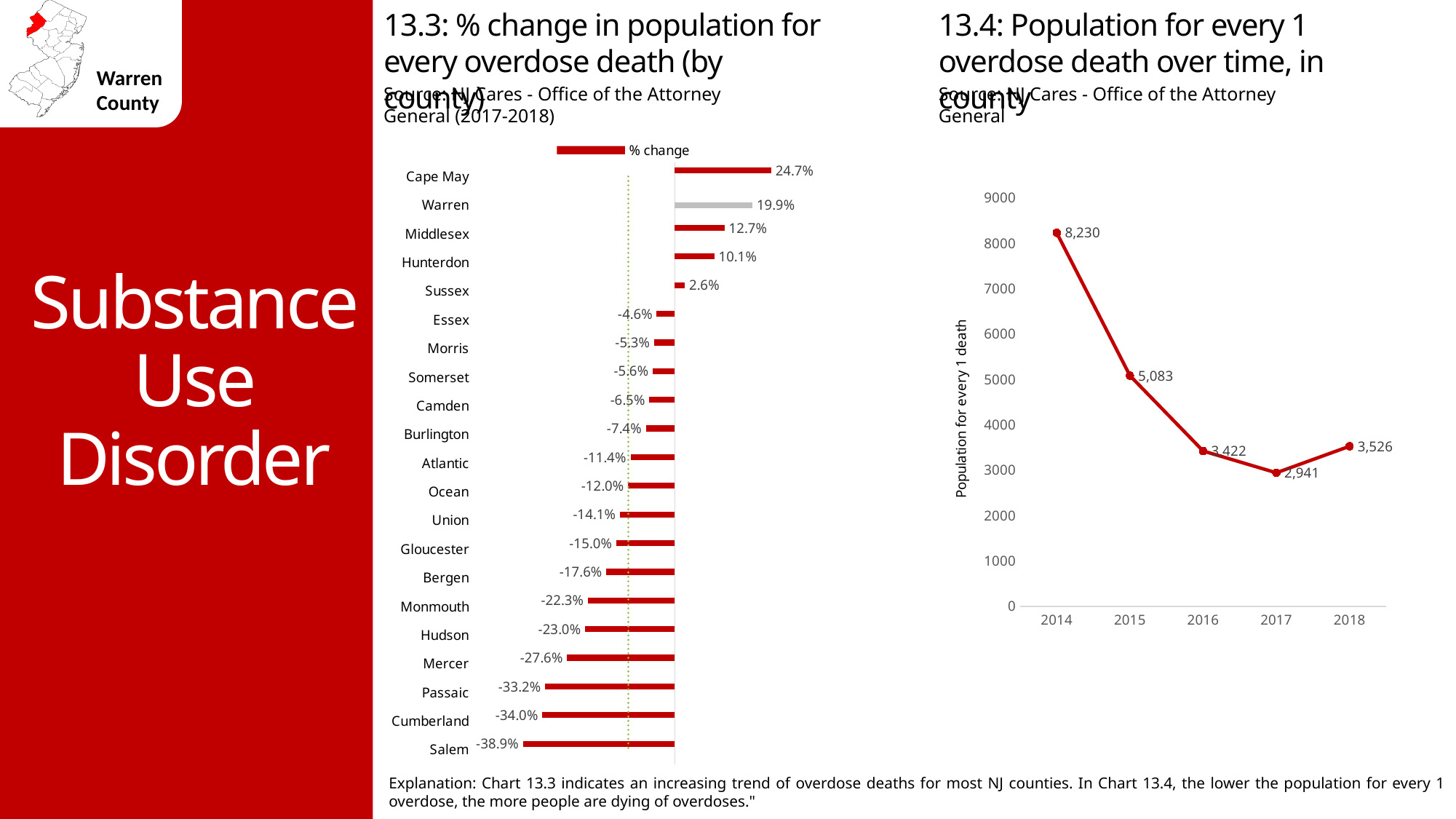
In chart 13.3, which county has the highest % change? Cape May In chart 13.3, how many counties are shown? 21 In chart 13.3, which county has the lowest % change? Salem In chart 13.4 (Population for every 1 overdose death over time), what is the value for 2014? 8,230 In chart 13.3, what is the difference between the values for Cape May and Warren? 4.8 percentage points In chart 13.4, how many data points are plotted? 5 In chart 13.4, what is the difference between the 2014 and 2015 values? 3,147 In chart 13.3, what is the value for Hunterdon? 10.1% In chart 13.3 (% change in population for every overdose death by county), what is the value for Warren? 19.9% In chart 13.3, which has a larger % change, Middlesex or Sussex? Middlesex What kind of chart is chart 13.4? Line chart In chart 13.4, which year has the lowest population for every 1 overdose death? 2017